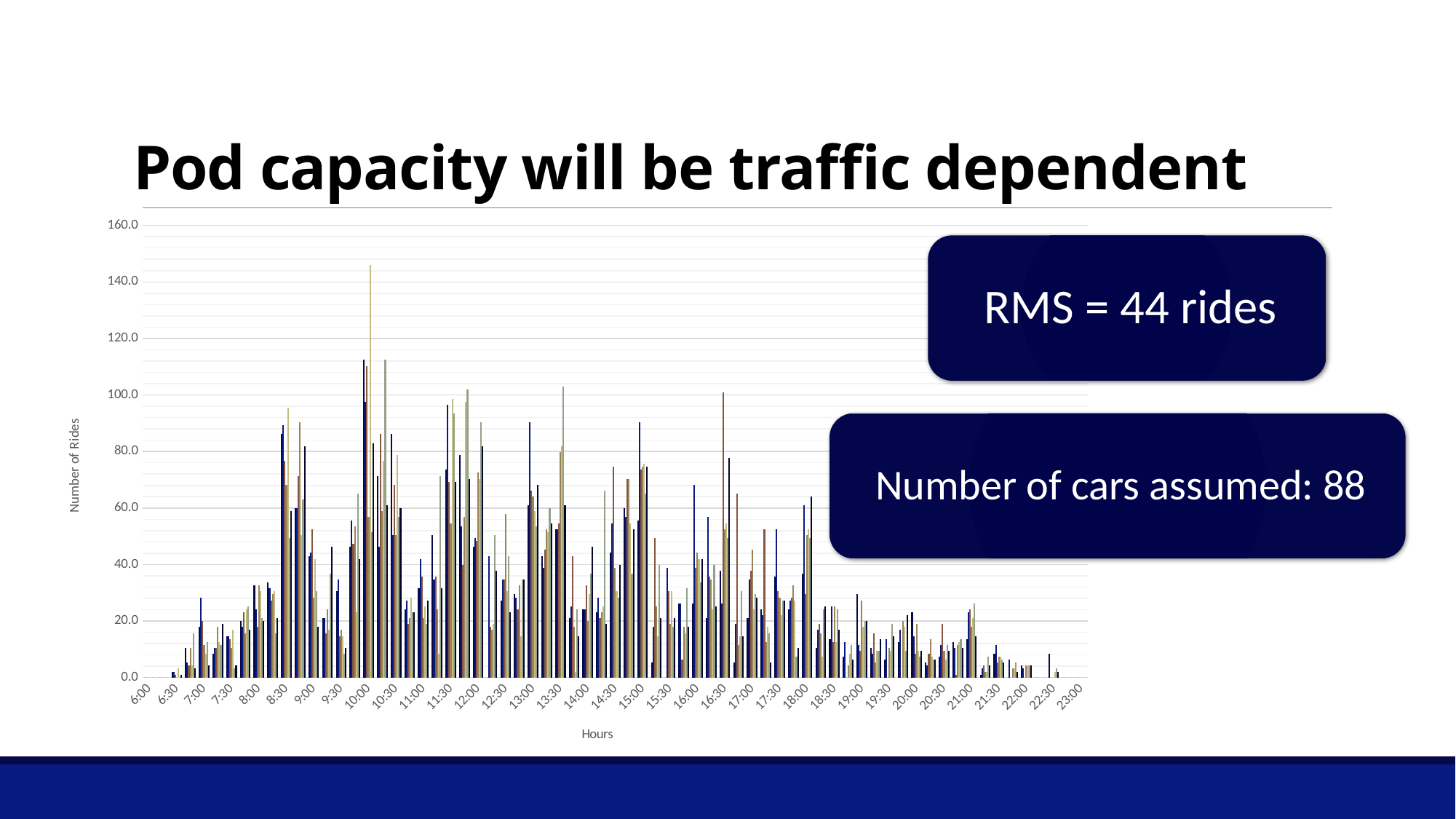
What is the first time label on the x axis of the chart? 6:00 What is the title of the x axis of the chart? Hours Is the tallest bar in the chart, near 10:00, greater or less than 120? greater Do the values generally rise or fall along the x axis from 18:30 to 23:00? fall What is the highest value shown on the y axis of the chart? 160.0 What is the title of the y axis of the chart? Number of Rides What is the last time label on the x axis of the chart? 23:00 What kind of chart is shown on the slide? bar chart Do the values generally rise or fall along the x axis from 6:00 to 8:30? rise How many time labels are shown on the x axis of the chart? 35 Are the bars around 22:00 greater or less than 20? less Are the bars around 6:30 greater or less than 20? less